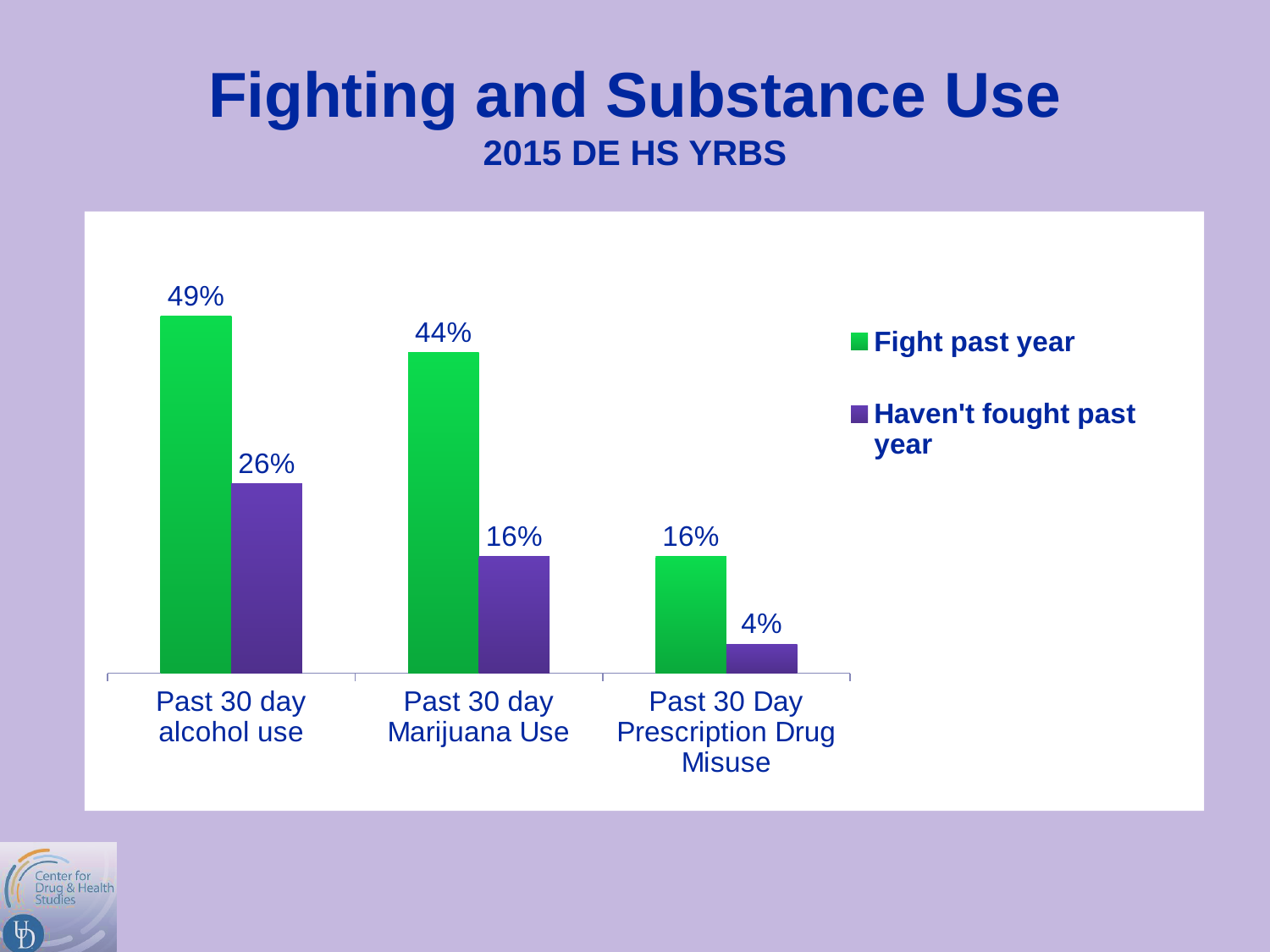
How many categories are shown on the x axis? 3 Which category has the lowest value for Haven't fought past year? Past 30 Day Prescription Drug Misuse How many series does the legend list? 2 What kind of chart is shown on the slide? Bar chart What is the difference between Fight past year and Haven't fought past year for Past 30 day Marijuana Use? 28% What is the value for Haven't fought past year for Past 30 Day Prescription Drug Misuse? 4% Which category has the highest value for Fight past year? Past 30 day alcohol use What is the value for Fight past year for Past 30 Day Prescription Drug Misuse? 16% What is the difference between Fight past year and Haven't fought past year for Past 30 day alcohol use? 23% Which is larger: Haven't fought past year for Past 30 day alcohol use or Fight past year for Past 30 Day Prescription Drug Misuse? Haven't fought past year for Past 30 day alcohol use What is the value for Fight past year for Past 30 day alcohol use? 49% What is the value for Haven't fought past year for Past 30 day Marijuana Use? 16%